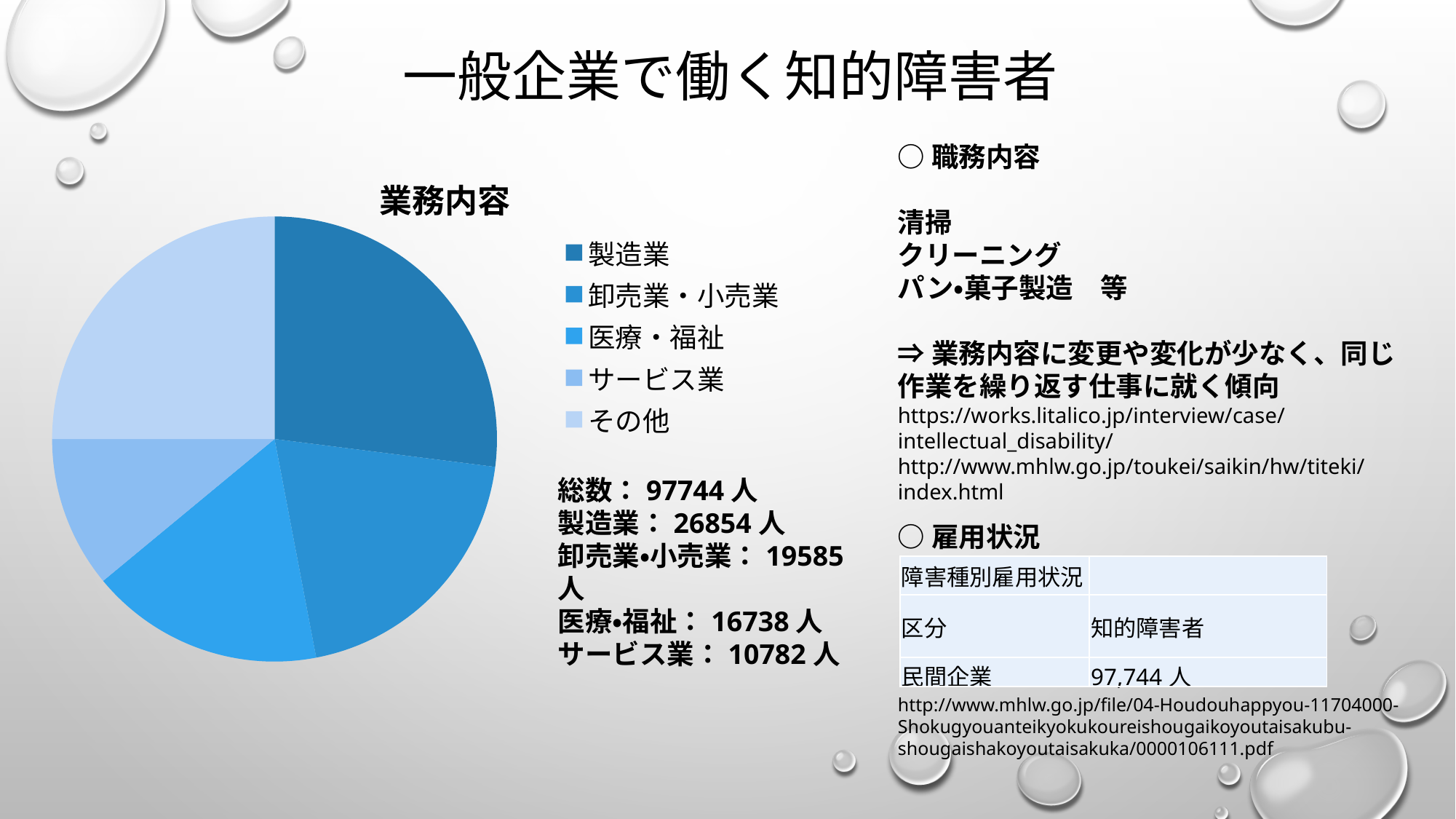
What is the total (総数) represented by the pie chart? 97744 人 What is the title of the pie chart? 業務内容 Which category has the smallest slice of the pie chart? サービス業 What kind of chart is shown on the slide? pie chart What is the value for 製造業? 26854 人 How many entries does the legend of the pie chart list? 5 What is the value for 医療・福祉? 16738 人 What is the value for サービス業? 10782 人 How many categories does the pie chart have? 5 What is the value for 卸売業・小売業? 19585 人 What is the difference between the values for 製造業 and 卸売業・小売業? 7269 人 Which category has the largest slice of the pie chart? 製造業